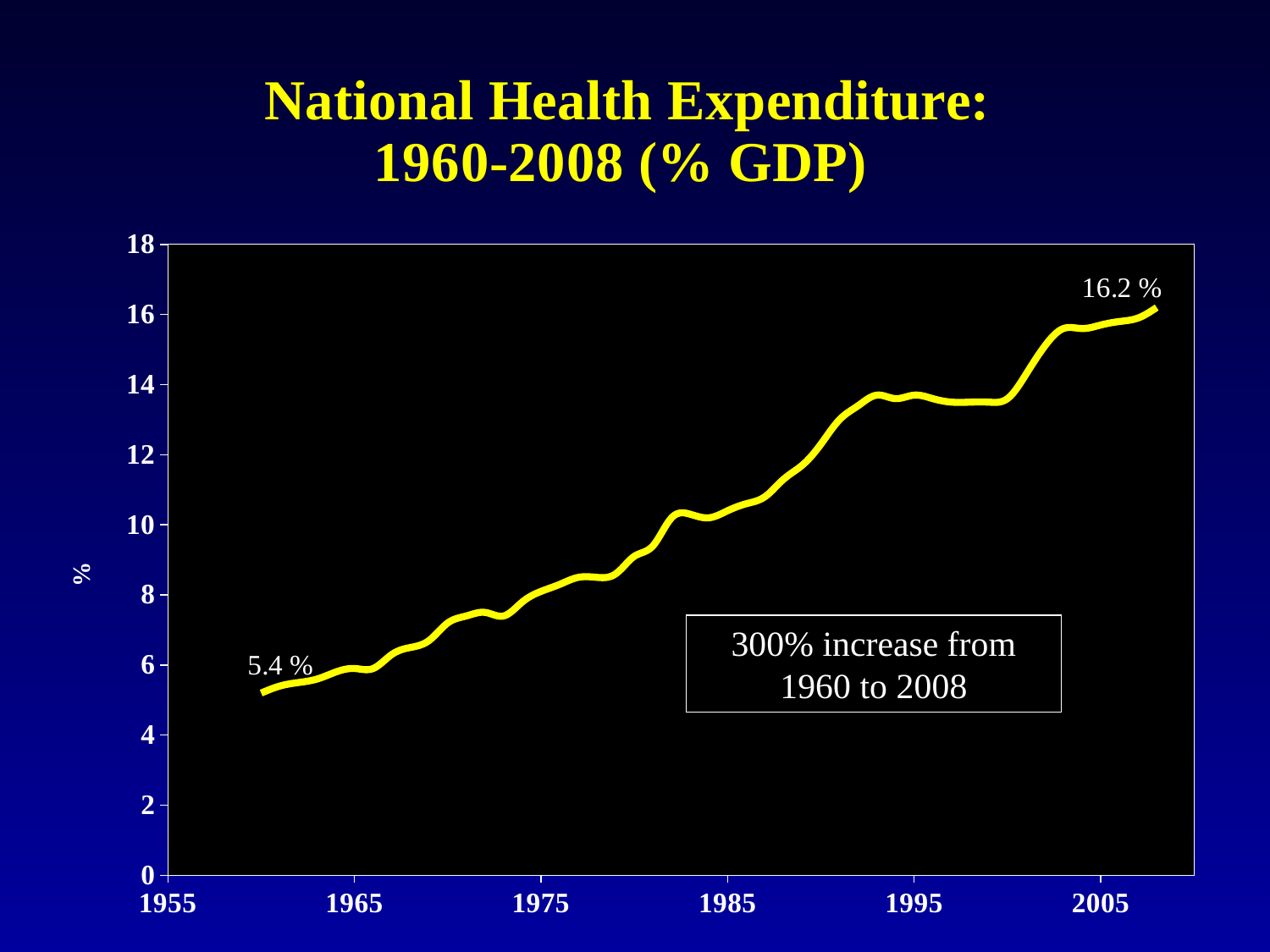
What is the value labelled at the start of the line, for 1960? 5.4 % What is the title of the chart? National Health Expenditure: 1960-2008 (% GDP) Is the value for 1970 greater or less than 6? greater In which year does the line reach its highest value? 2008 What kind of chart is shown on the slide? line chart Which is larger, the value for 1960 or the value for 2008? 2008 Do the values rise or fall from 1960 to 2008? rise What is the difference between the 2008 value and the 1960 value? 10.8 % What is the value labelled at the end of the line, for 2008? 16.2 % What does the text box inside the chart say? 300% increase from 1960 to 2008 Is the value for 1995 greater or less than 12? greater In which year does the line have its lowest value? 1960